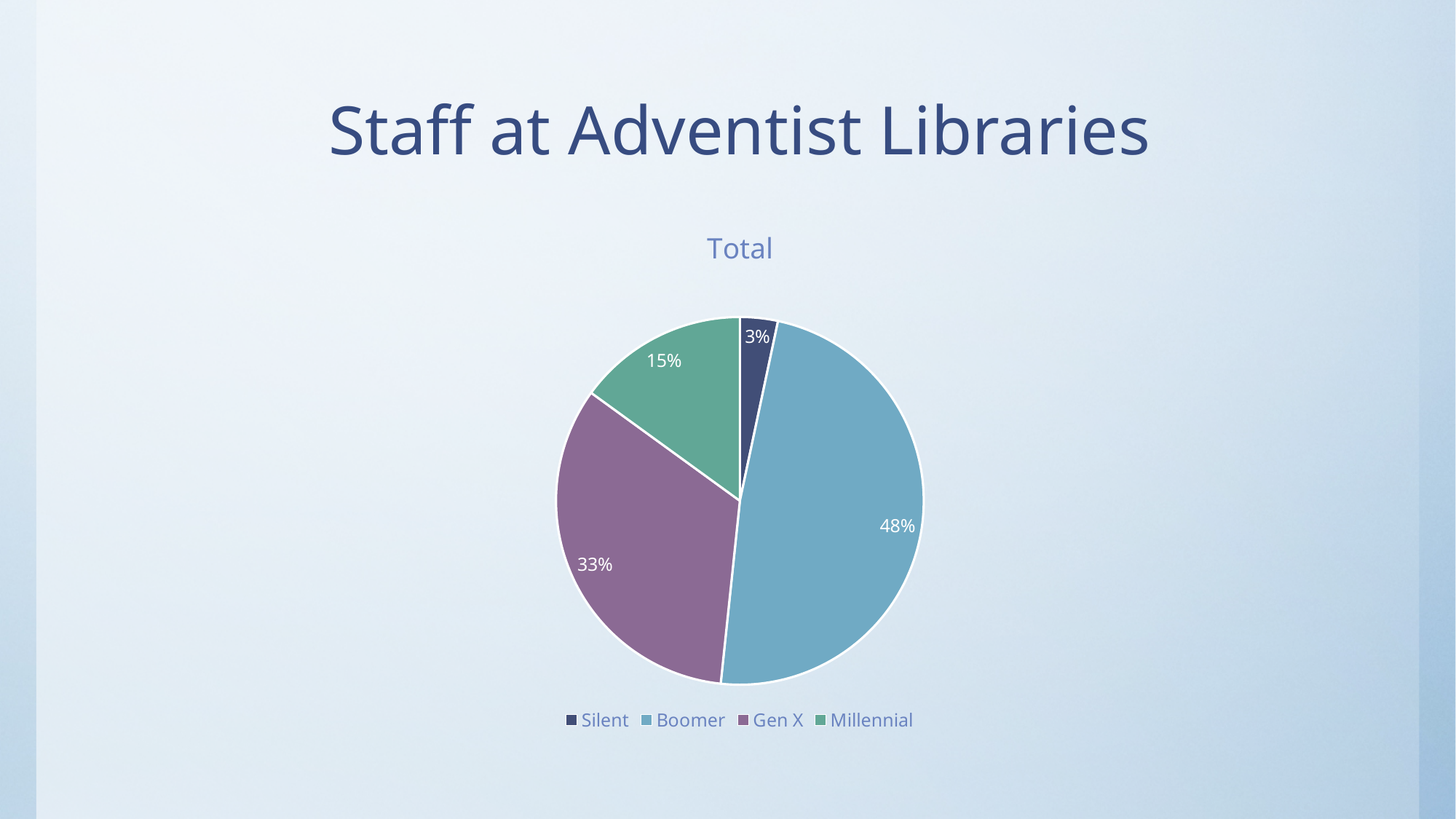
Which category has the smallest slice of the pie? Silent What share of the pie does Silent represent? 3% What kind of chart is shown on the slide? Pie chart What share of the pie does Boomer represent? 48% Which category is shown in green in the legend? Millennial What share of the pie does Gen X represent? 33% What is the title of the chart? Total Which category has the largest slice of the pie? Boomer How many categories are shown in the pie chart? 4 What is the difference in percentage points between the Boomer and Gen X slices? 15 Which slice is larger, Millennial or Gen X? Gen X